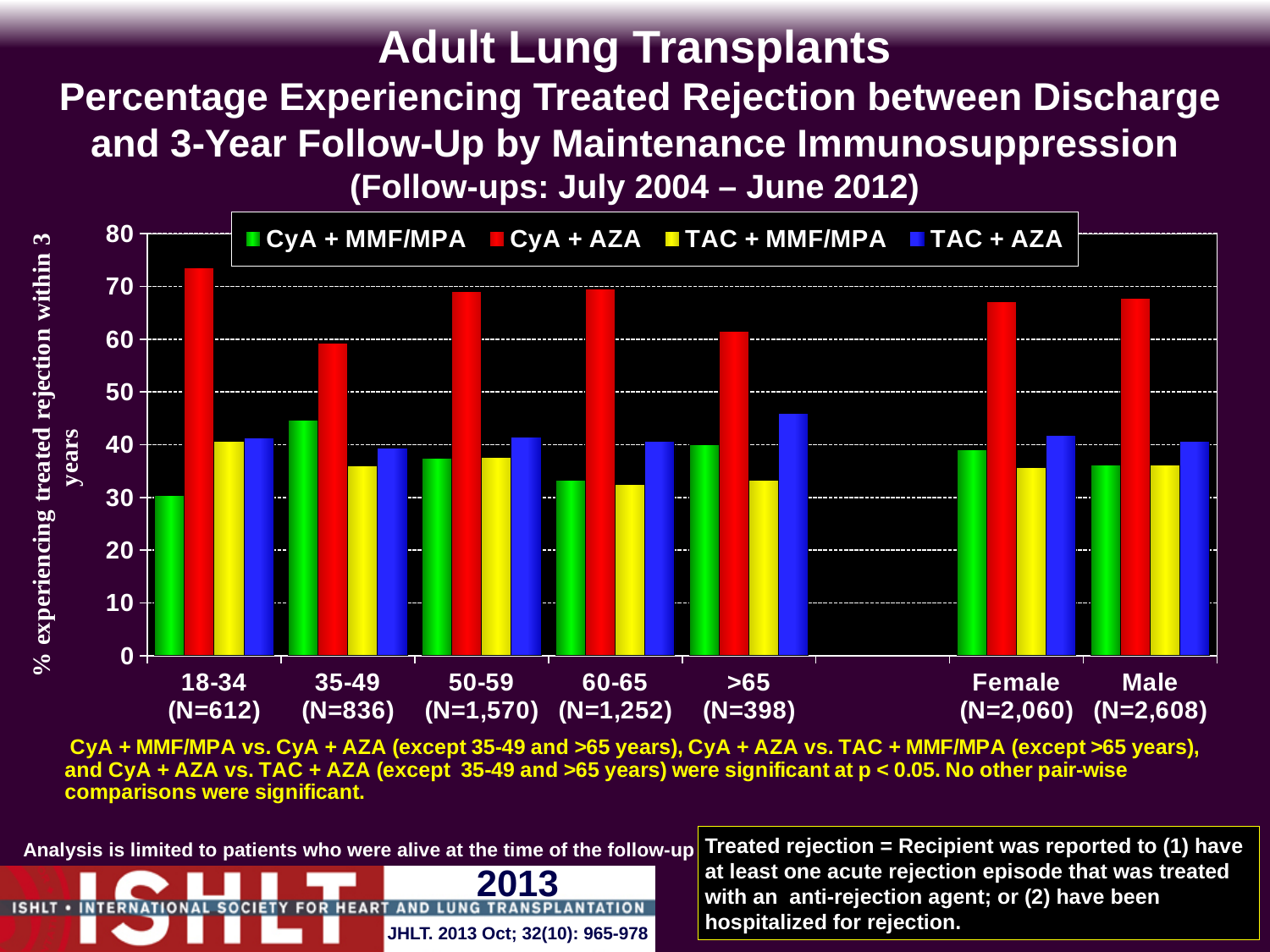
Is the value for CyA + MMF/MPA in the 18-34 age group greater or less than 40? less In the 35-49 age group, which is larger: CyA + MMF/MPA or TAC + MMF/MPA? CyA + MMF/MPA How many series does the legend list? 4 Is the value for TAC + AZA in the >65 age group greater or less than 40? greater Is the value for CyA + AZA in the 18-34 age group greater or less than 70? greater Which age group has the highest value for CyA + AZA? 18-34 What kind of chart is shown on the slide? bar chart How many categories are shown along the x axis? 7 What colour represents CyA + AZA in the legend? red In the >65 age group, which is larger: TAC + AZA or TAC + MMF/MPA? TAC + AZA Which immunosuppression regimen has the highest value in the 60-65 age group? CyA + AZA What is the maximum value shown on the y axis? 80